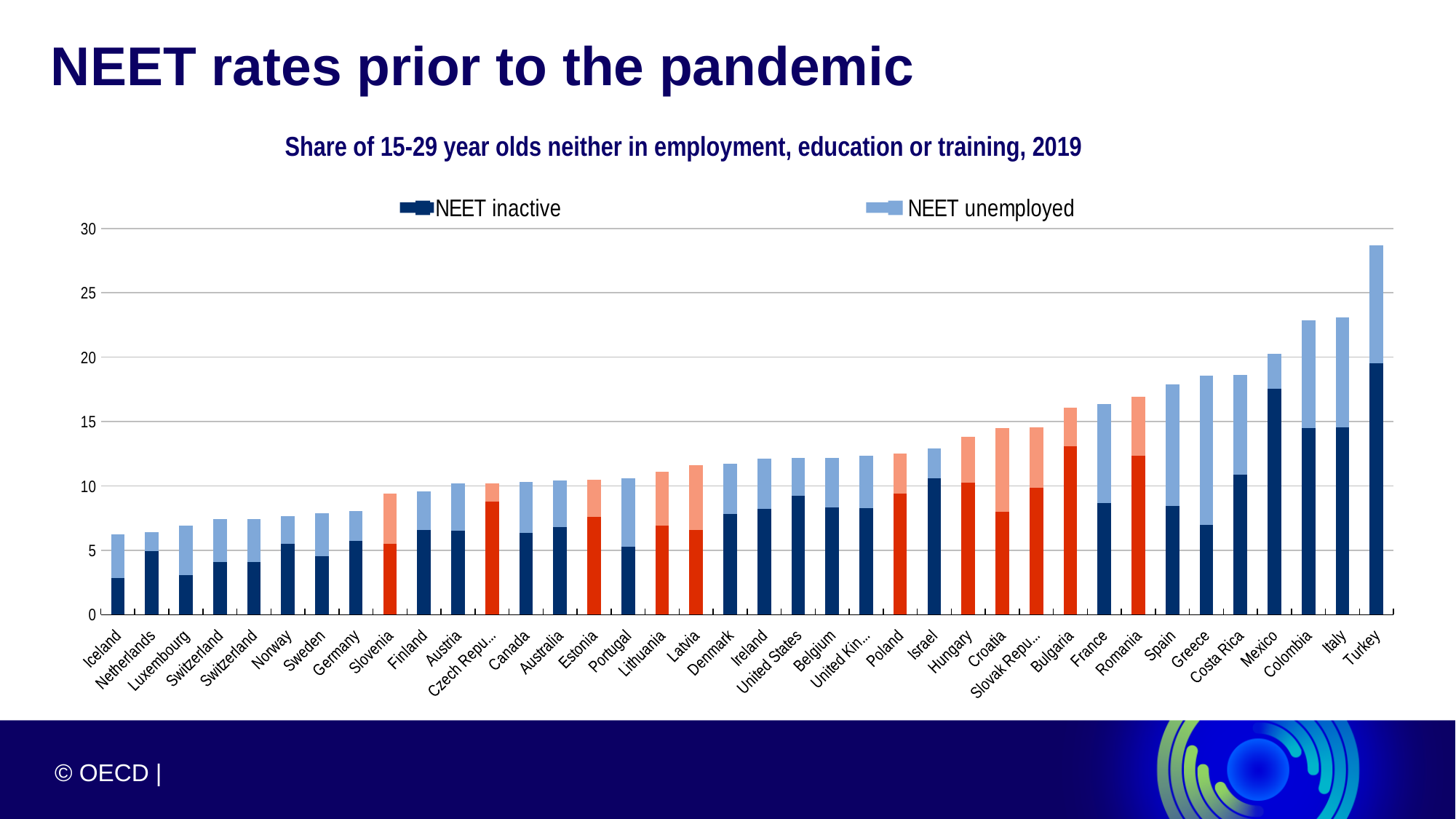
Which country has the lowest total NEET rate? Iceland What are the two series named in the legend? NEET inactive and NEET unemployed Do the total NEET rates rise or fall moving from left to right along the x axis? rise What kind of chart is shown on the slide? Stacked bar chart Is the total NEET rate for Iceland greater or less than 10? less What is the subtitle of the chart? Share of 15-29 year olds neither in employment, education or training, 2019 Is the total NEET rate for Turkey greater or less than 25? greater Is the NEET inactive value for Turkey greater or less than 15? greater Which country has the highest total NEET rate? Turkey How many series does the legend list? 2 Which has a larger total NEET rate, Turkey or Italy? Turkey